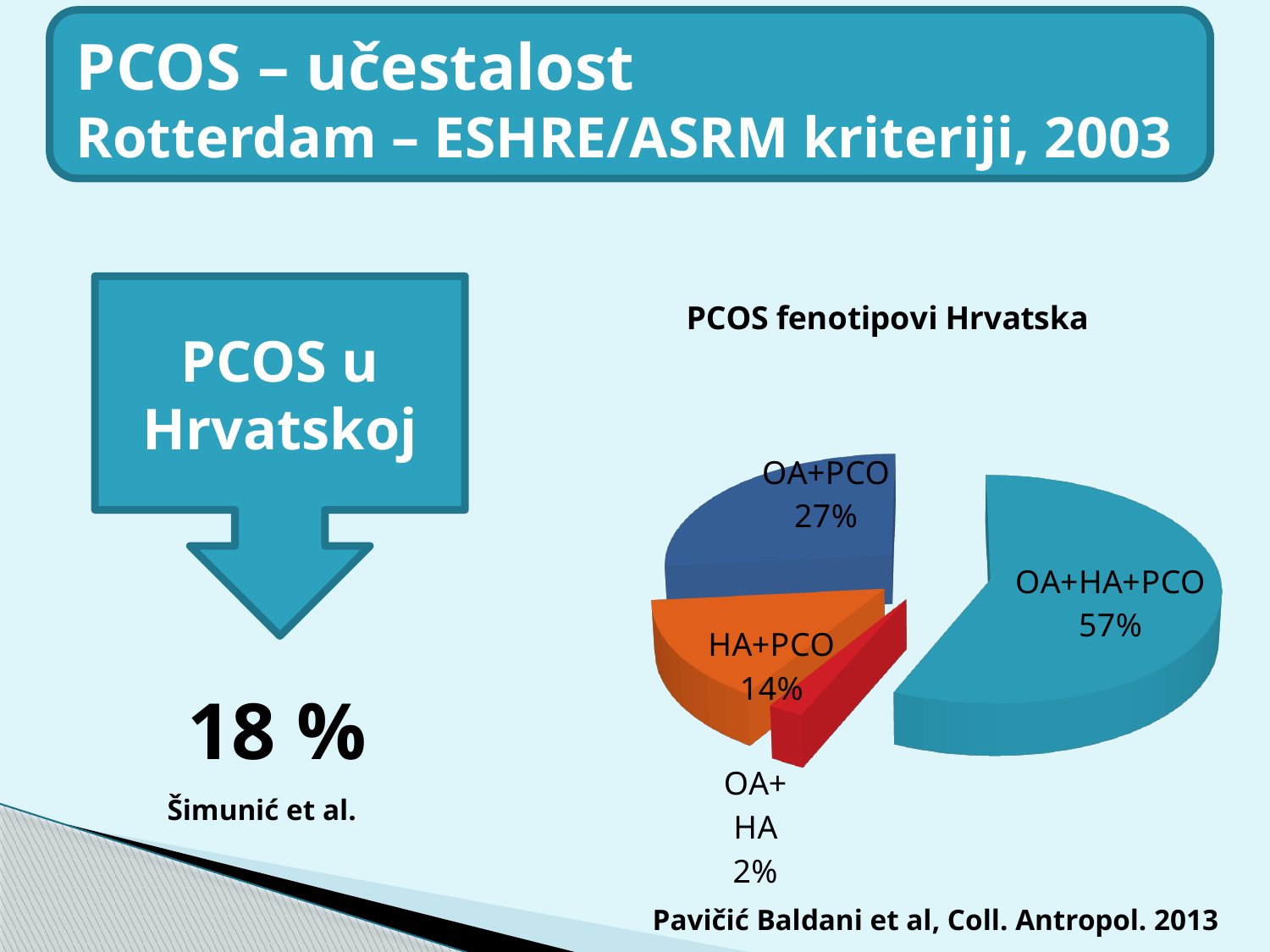
Which phenotype has the smallest share in the pie chart? OA+HA Which phenotype has the largest share in the pie chart? OA+HA+PCO What is the value for OA+HA+PCO in the pie chart? 57% What is the value for HA+PCO in the pie chart? 14% Which is larger in the pie chart, HA+PCO or OA+PCO? OA+PCO What is the value for OA+HA in the pie chart? 2% What is the title of the pie chart? PCOS fenotipovi Hrvatska What is the value for OA+PCO in the pie chart? 27% What type of chart is shown under the title 'PCOS fenotipovi Hrvatska'? pie chart How many slices does the pie chart have? 4 What is the difference between the HA+PCO and OA+HA shares in the pie chart? 12% What is the difference between the OA+HA+PCO and OA+PCO shares in the pie chart? 30%